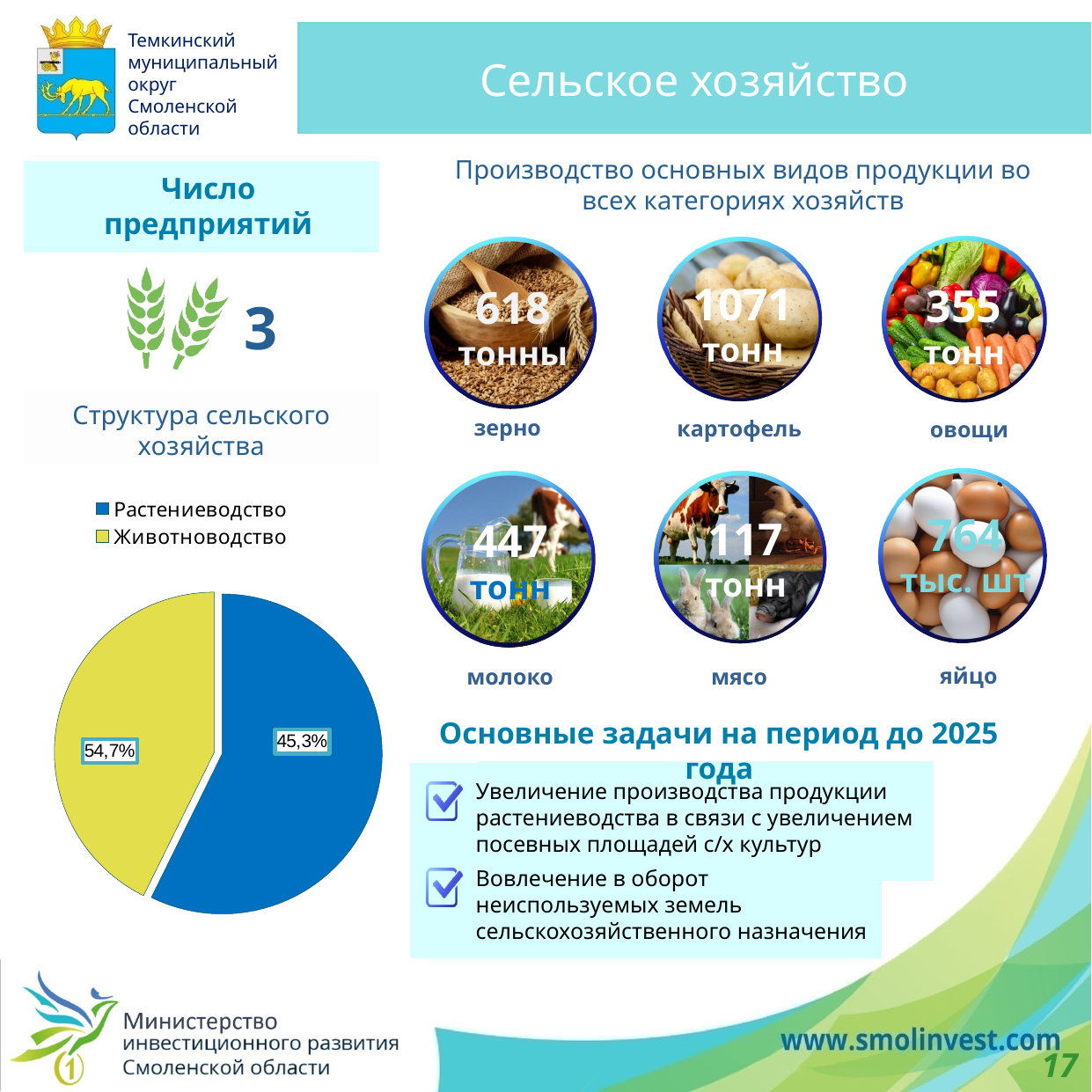
In the pie chart "Структура сельского хозяйства", by how many percentage points does Животноводство exceed Растениеводство? 9,4 How many entries does the legend of the pie chart "Структура сельского хозяйства" list? 2 In the pie chart "Структура сельского хозяйства", what share does Растениеводство have? 45,3% In the pie chart "Структура сельского хозяйства", what colour is the Растениеводство slice? blue How many slices does the pie chart "Структура сельского хозяйства" have? 2 What kind of chart is shown under the heading "Структура сельского хозяйства"? pie chart In the pie chart "Структура сельского хозяйства", what share does Животноводство have? 54,7% In the pie chart "Структура сельского хозяйства", what colour is the Животноводство slice? yellow